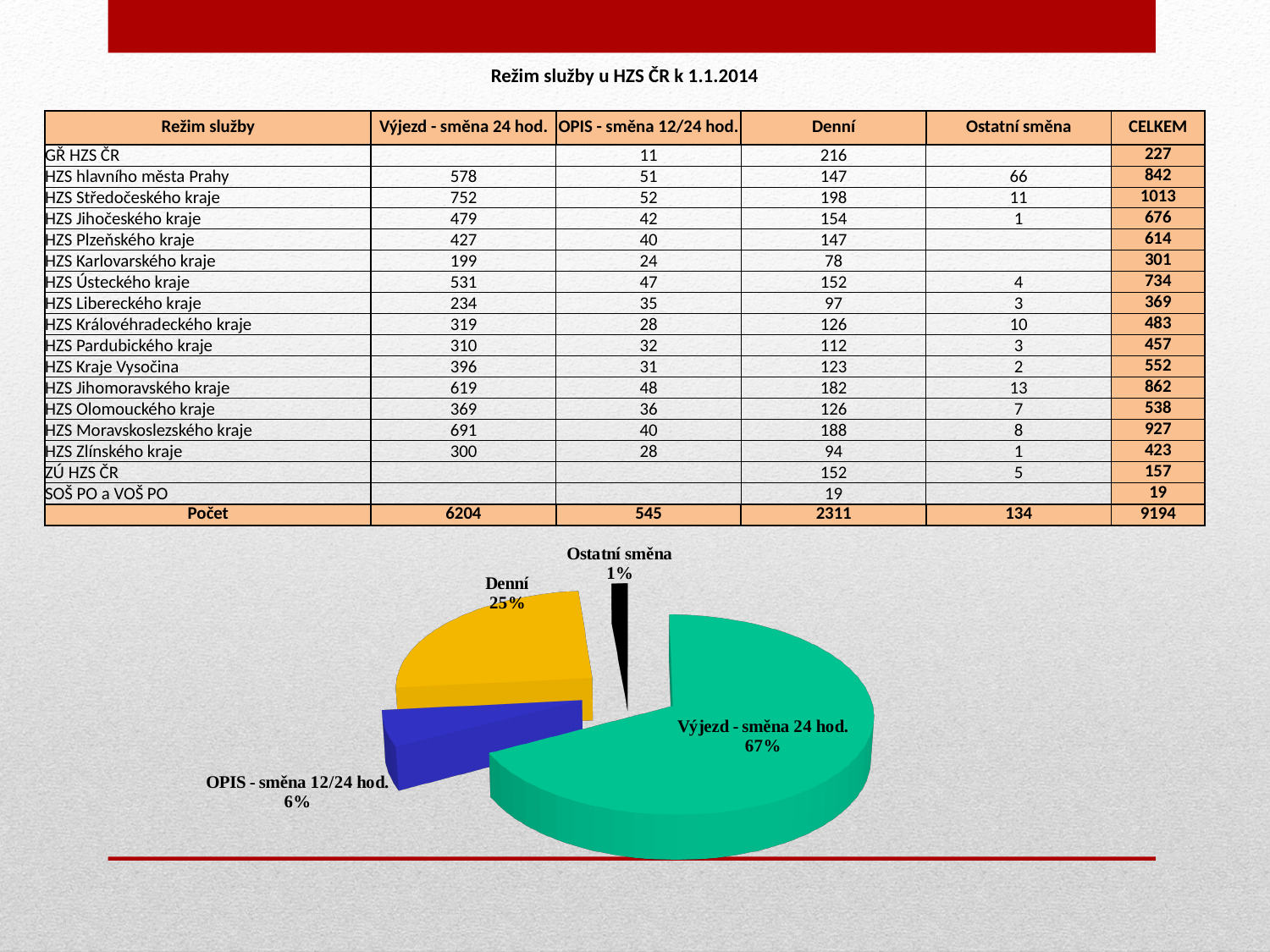
Which slice of the pie chart is the smallest? Ostatní směna In the pie chart, what is the difference in percentage points between the "OPIS - směna 12/24 hod." share and the "Ostatní směna" share? 5 How many slices does the pie chart have? 4 What share of the pie chart does "OPIS - směna 12/24 hod." represent? 6% Which slice of the pie chart is the largest? Výjezd - směna 24 hod. What share of the pie chart does "Ostatní směna" represent? 1% In the pie chart, which is larger: the share for "Denní" or the share for "OPIS - směna 12/24 hod."? Denní What colour is the "Denní" slice in the pie chart? yellow What kind of chart is shown on the slide? pie chart What share of the pie chart does "Výjezd - směna 24 hod." represent? 67% In the pie chart, what is the difference in percentage points between the "Výjezd - směna 24 hod." share and the "Denní" share? 42